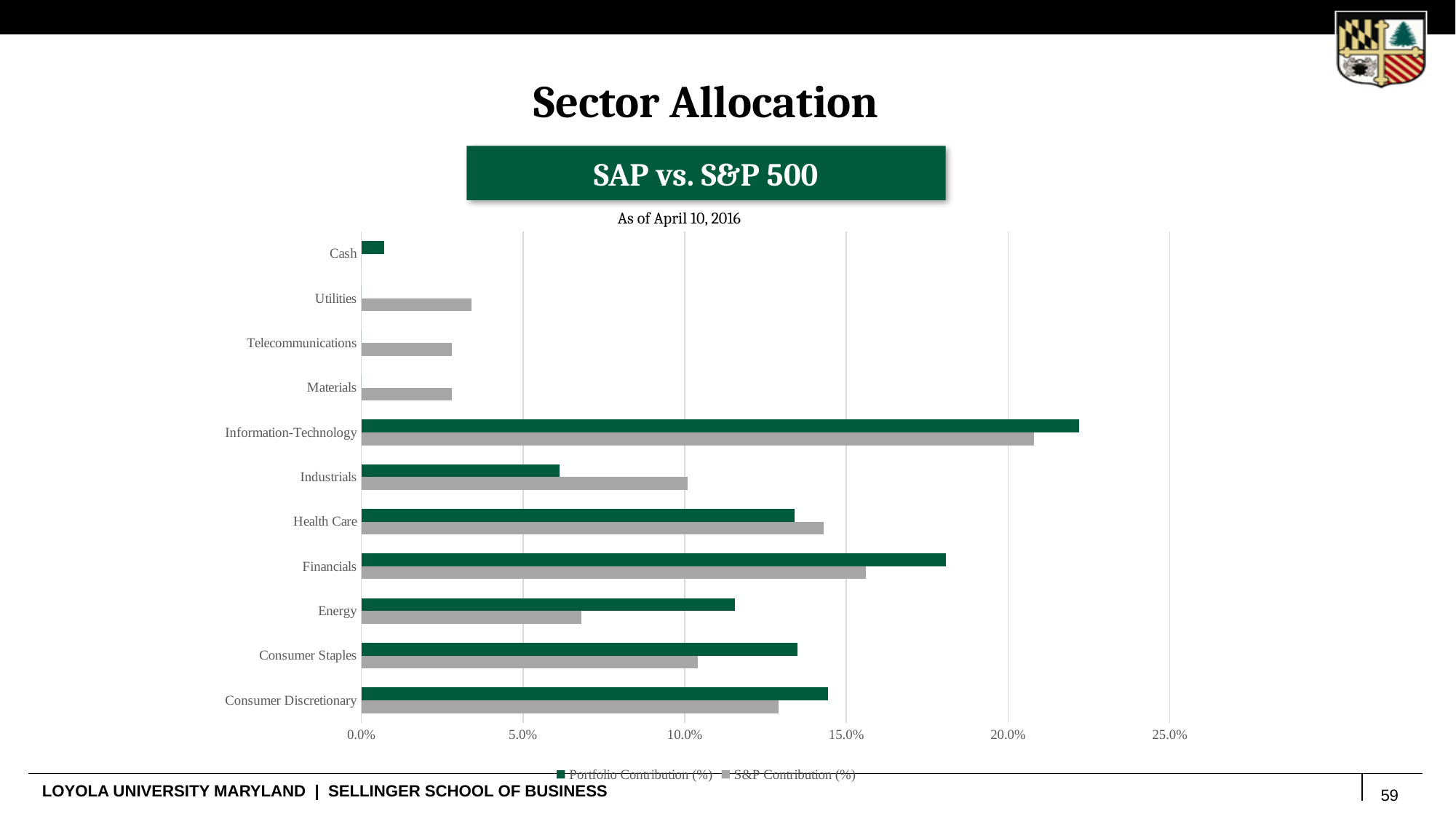
Which category has the highest S&P Contribution (%)? Information-Technology Is the Portfolio Contribution (%) for Consumer Discretionary greater or less than 15.0%? less Which category has the highest Portfolio Contribution (%)? Information-Technology What kind of chart is shown on the slide? bar chart For Industrials, which is larger: Portfolio Contribution (%) or S&P Contribution (%)? S&P Contribution (%) Is the Portfolio Contribution (%) for Financials greater or less than 15.0%? greater For Energy, which is larger: Portfolio Contribution (%) or S&P Contribution (%)? Portfolio Contribution (%) Is the S&P Contribution (%) for Utilities greater or less than 5.0%? less What date is the chart data as of? April 10, 2016 How many sector categories are plotted on the chart? 11 How many series does the legend list? 2